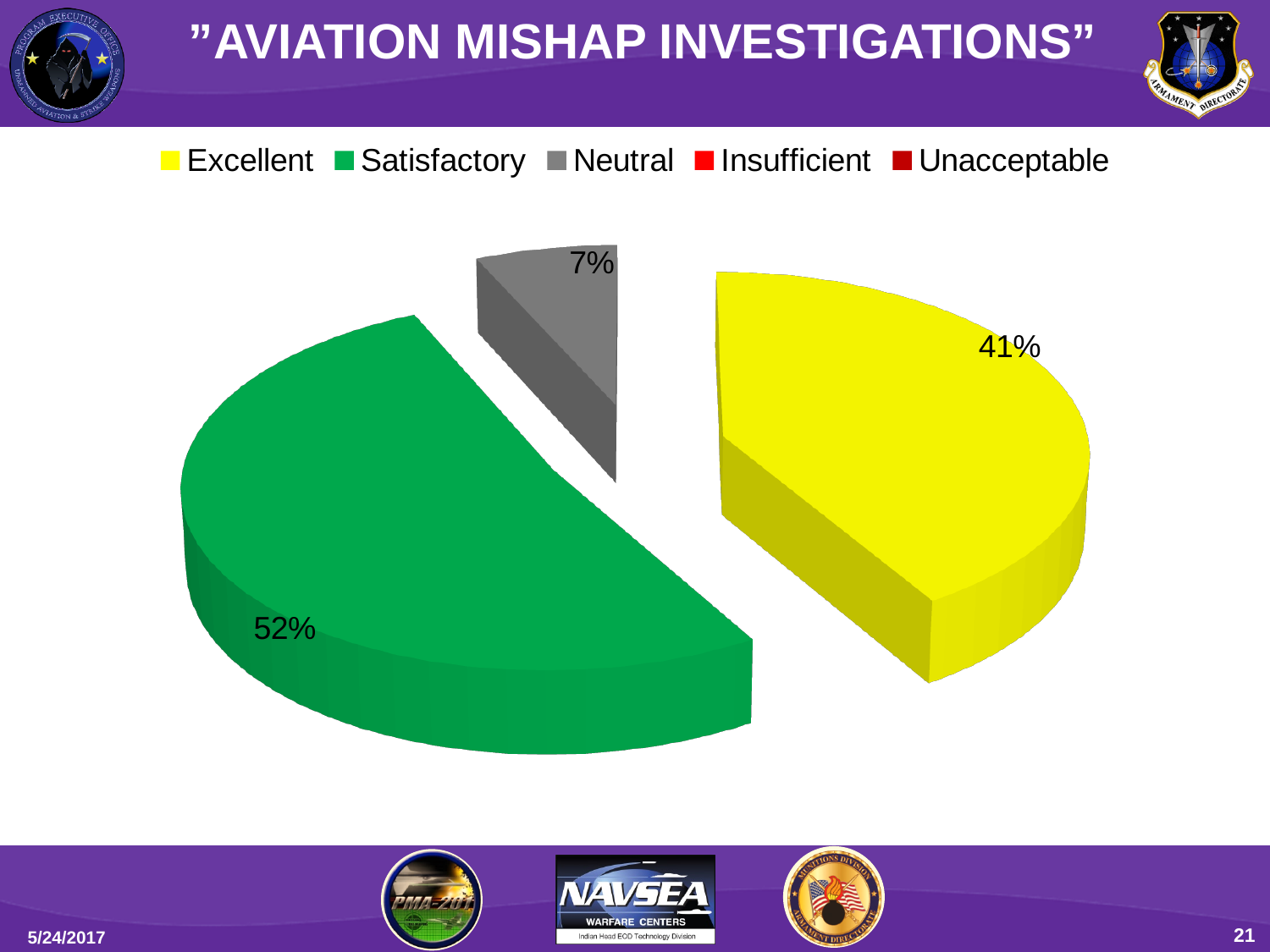
What percentage of the pie is labelled for the Satisfactory slice? 52% Which of the labelled slices is the smallest? Neutral What is the title of the chart slide? "AVIATION MISHAP INVESTIGATIONS" What kind of chart is shown on the slide? pie chart What percentage of the pie is labelled for the Excellent slice? 41% Which category has the largest slice of the pie? Satisfactory Which slice is larger, Excellent or Neutral? Excellent How many slices with a percentage label are visible in the pie? 3 What percentage of the pie is labelled for the Neutral slice? 7% How many categories does the legend list? 5 What is the difference in percentage points between the Satisfactory and Excellent slices? 11 What colour represents the Excellent category in the legend? yellow